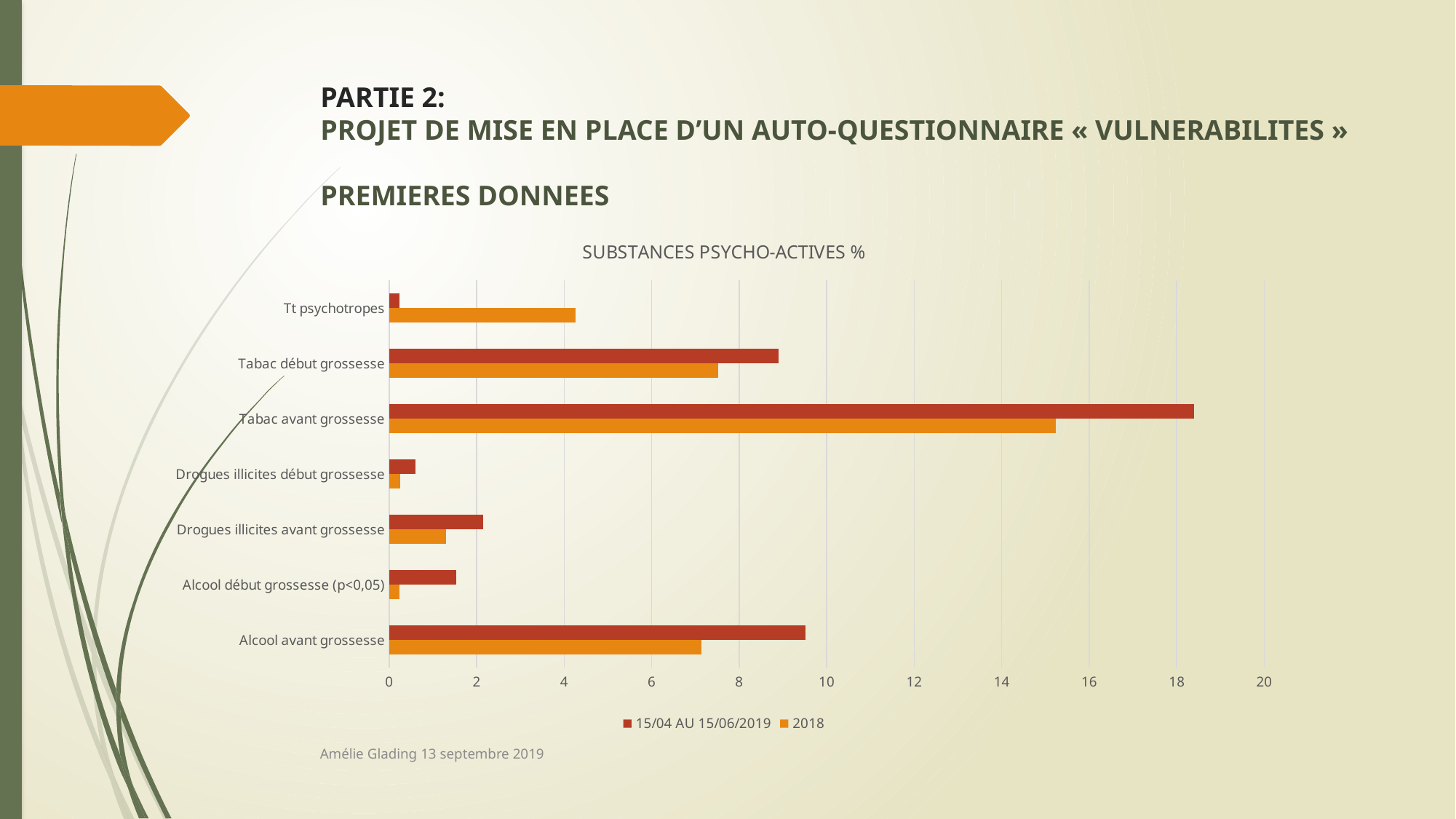
Is the 2018 value for Tabac début grossesse greater or less than 6? greater How many series does the chart legend list? 2 Is the 2018 value for Tabac avant grossesse greater or less than 14? greater How many categories are listed on the vertical axis of the chart? 7 Which category has the highest value for the 2018 series? Tabac avant grossesse For Alcool avant grossesse, which series has the larger value: 15/04 AU 15/06/2019 or 2018? 15/04 AU 15/06/2019 Is the 15/04 AU 15/06/2019 value for Tabac avant grossesse greater or less than 16? greater What kind of chart is shown on the slide? bar chart For Tt psychotropes, which series has the larger value: 15/04 AU 15/06/2019 or 2018? 2018 Which category has the highest value for the 15/04 AU 15/06/2019 series? Tabac avant grossesse What is the title of the chart? SUBSTANCES PSYCHO-ACTIVES %